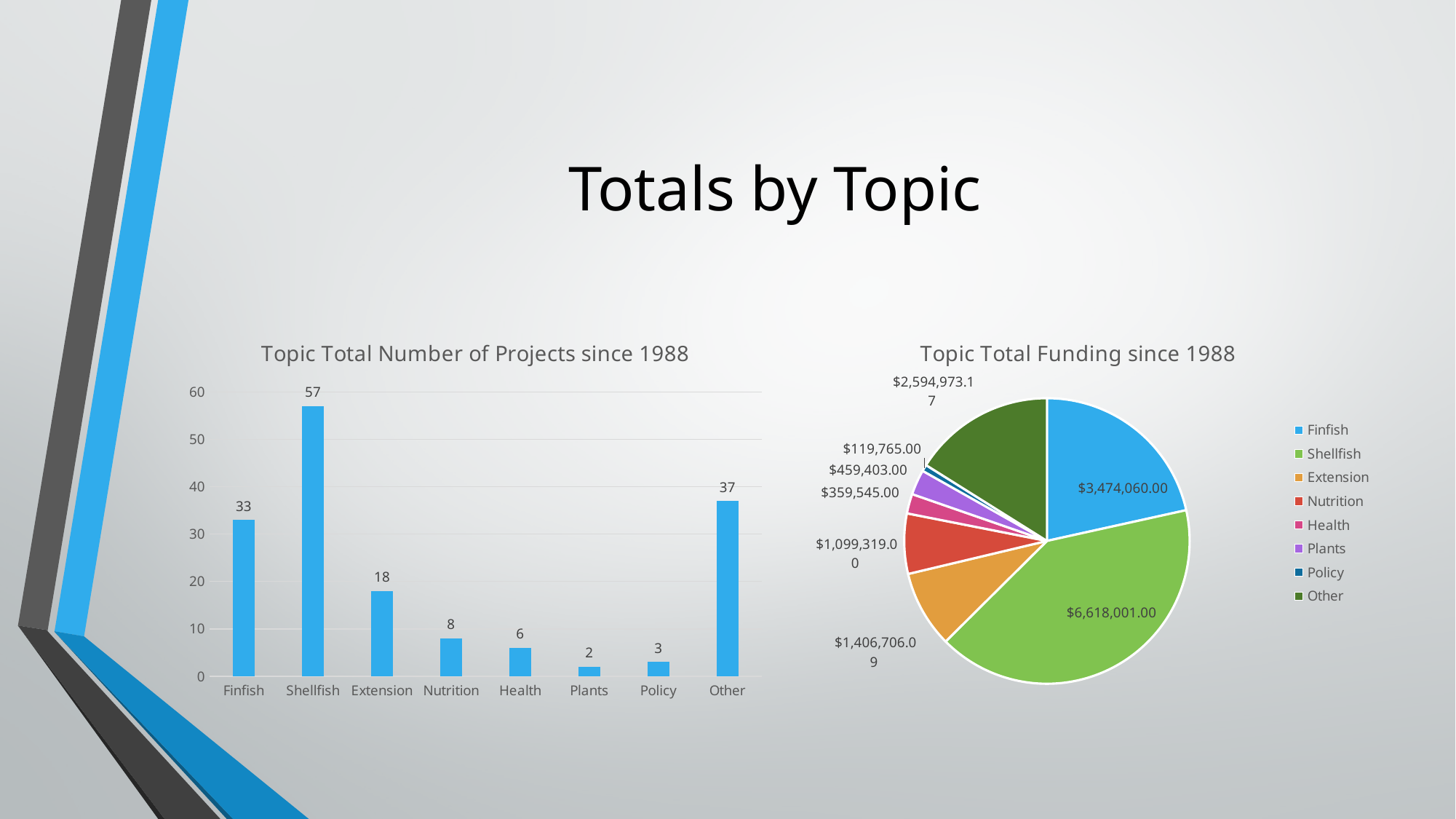
In the 'Topic Total Funding since 1988' pie chart, what is the funding for Policy? $119,765.00 In the 'Topic Total Number of Projects since 1988' chart, which topic has the most projects? Shellfish In the 'Topic Total Number of Projects since 1988' chart, which has more projects, Extension or Health? Extension In the 'Topic Total Number of Projects since 1988' chart, how many projects does Shellfish have? 57 How many topics are shown on the x axis of the 'Topic Total Number of Projects since 1988' chart? 8 In the 'Topic Total Number of Projects since 1988' chart, which topic has the fewest projects? Plants In the 'Topic Total Funding since 1988' pie chart, which topic has the largest funding? Shellfish In the 'Topic Total Number of Projects since 1988' chart, how many projects does Nutrition have? 8 How many entries does the legend of the 'Topic Total Funding since 1988' pie chart list? 8 What kind of chart is 'Topic Total Number of Projects since 1988'? Bar chart In the 'Topic Total Funding since 1988' pie chart, what is the funding for Shellfish? $6,618,001.00 In the 'Topic Total Number of Projects since 1988' chart, what is the difference between the number of projects for Other and for Finfish? 4